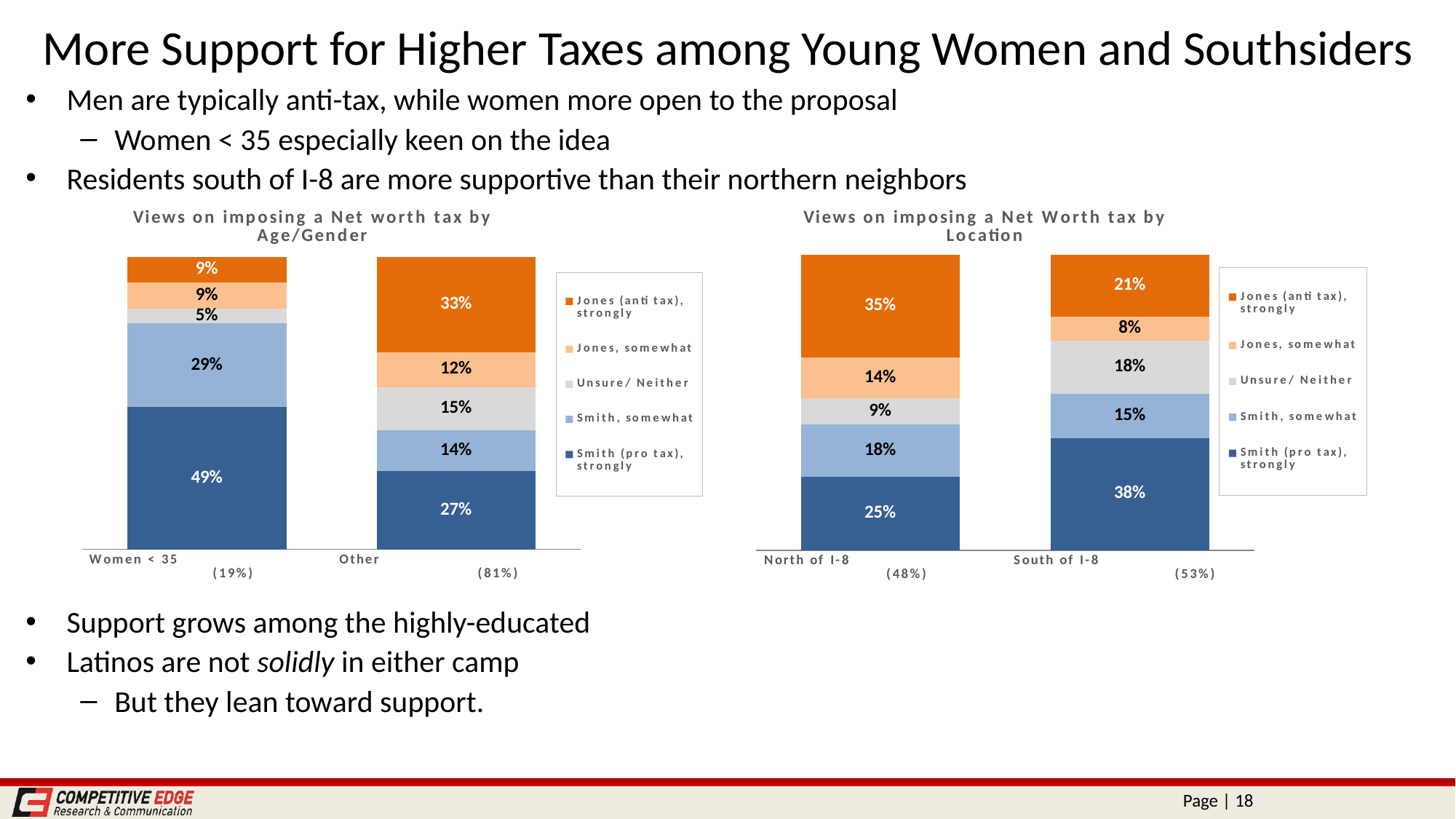
How many series does the legend of the 'Views on imposing a Net Worth tax by Location' chart list? 5 In the 'Views on imposing a Net Worth tax by Location' chart, what is the difference between the 'Jones (anti tax), strongly' values for North of I-8 and South of I-8? 14% In the 'Views on imposing a Net worth tax by Age/Gender' chart, which group has the higher 'Unsure/ Neither' value? Other In the 'Views on imposing a Net Worth tax by Location' chart, what is the 'Unsure/ Neither' value for North of I-8? 9% In the 'Views on imposing a Net Worth tax by Location' chart, what percentage of South of I-8 residents are 'Smith (pro tax), strongly'? 38% In the 'Views on imposing a Net worth tax by Age/Gender' chart, what is the 'Jones (anti tax), strongly' value for the Other group? 33% In the 'Views on imposing a Net Worth tax by Location' chart, which location has the larger 'Smith, somewhat' share, North of I-8 or South of I-8? North of I-8 How many categories are shown on the x axis of the 'Views on imposing a Net worth tax by Age/Gender' chart? 2 What type of chart is the 'Views on imposing a Net Worth tax by Location' chart? Stacked bar chart In the 'Views on imposing a Net worth tax by Age/Gender' chart, what is the difference between the 'Smith (pro tax), strongly' values for Women < 35 and Other? 22% In the 'Views on imposing a Net worth tax by Age/Gender' chart, what percentage of the sample is shown in parentheses under the Other category? 81% In the 'Views on imposing a Net worth tax by Age/Gender' chart, what percentage of Women < 35 are 'Smith (pro tax), strongly'? 49%